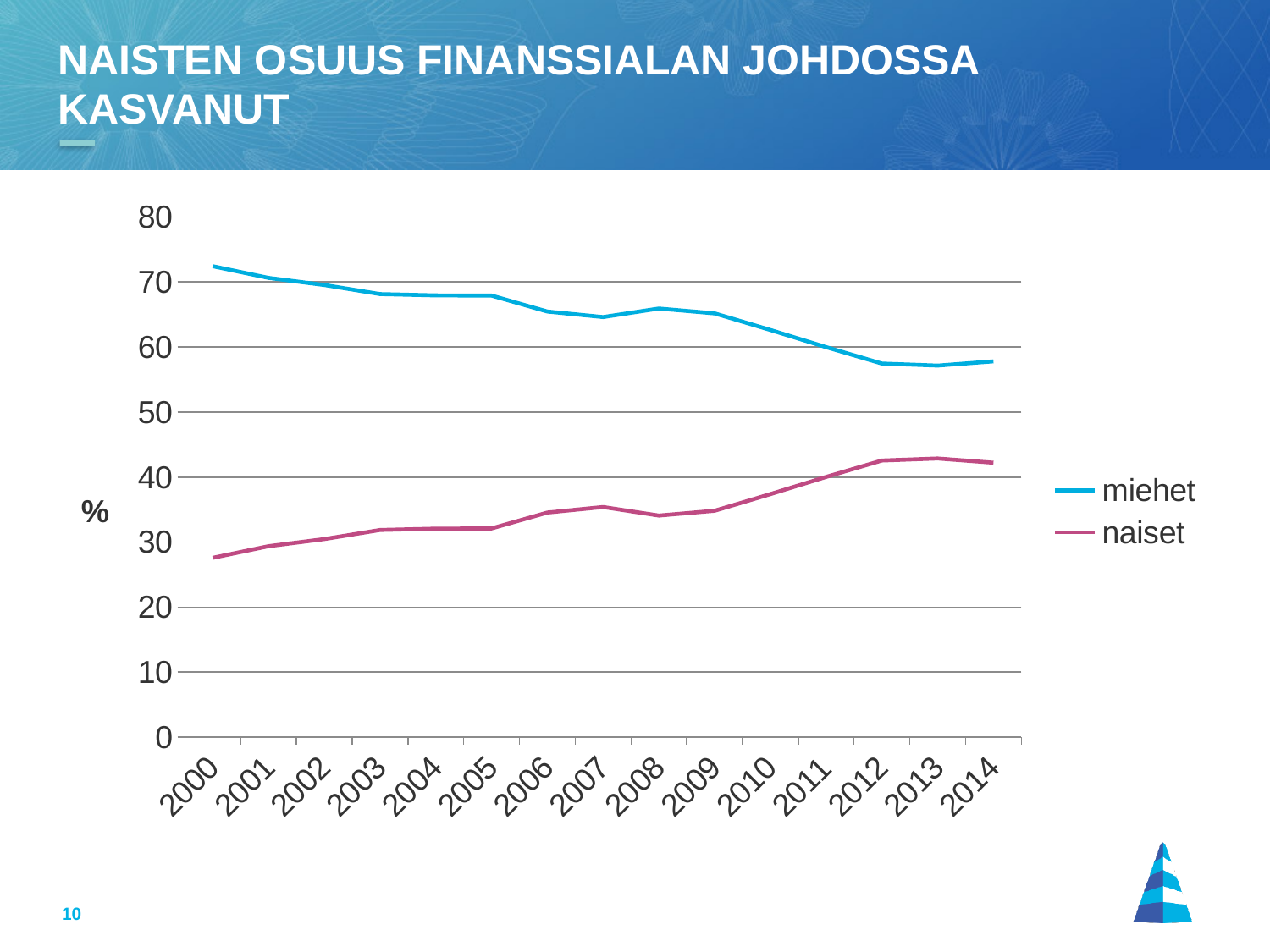
Does the miehet line rise or fall from 2000 to 2014? fall Is the value for naiset in 2000 greater or less than 30? less What kind of chart is shown on the slide? line chart What is the label on the vertical axis? % Does the naiset line rise or fall from 2000 to 2014? rise Is the value for miehet in 2000 greater or less than 70? greater Which series are listed in the legend? miehet, naiset How many series does the legend list? 2 Is the value for naiset in 2014 greater or less than 40? greater In which year is the miehet value highest? 2000 How many years are shown on the x axis? 15